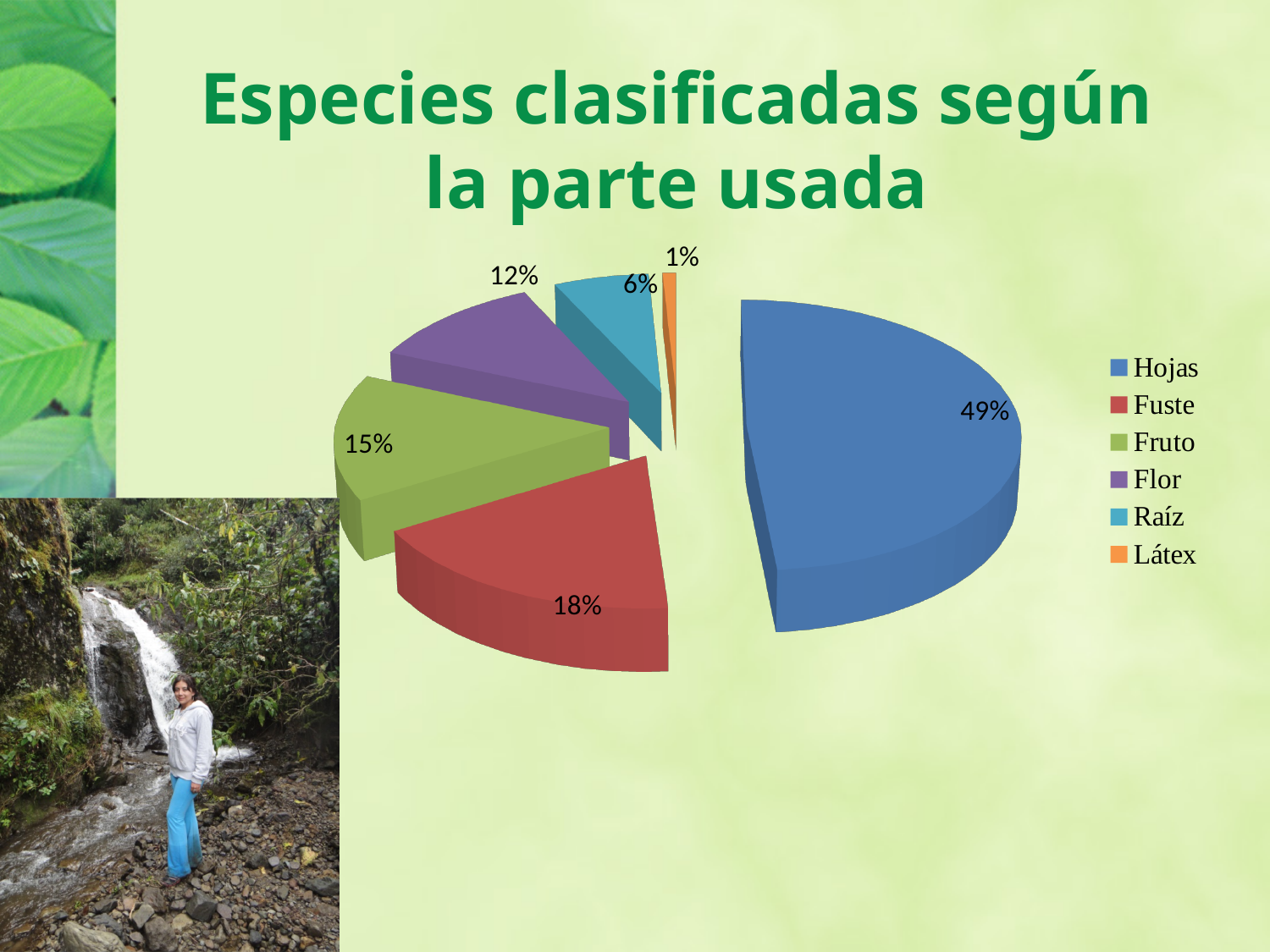
What is the difference between the shares of Hojas and Fuste? 31% What is the value shown for Flor? 12% What share of the pie does Hojas represent? 49% What is the value shown for Raíz? 6% How many categories does the legend list? 6 What is the value shown for Fuste? 18% What is the title of the chart on the slide? Especies clasificadas según la parte usada What kind of chart is shown on the slide? pie chart Which is larger, the share for Fruto or the share for Flor? Fruto Which category has the smallest share of the pie? Látex What is the value shown for Fruto? 15% Which category has the largest share of the pie? Hojas